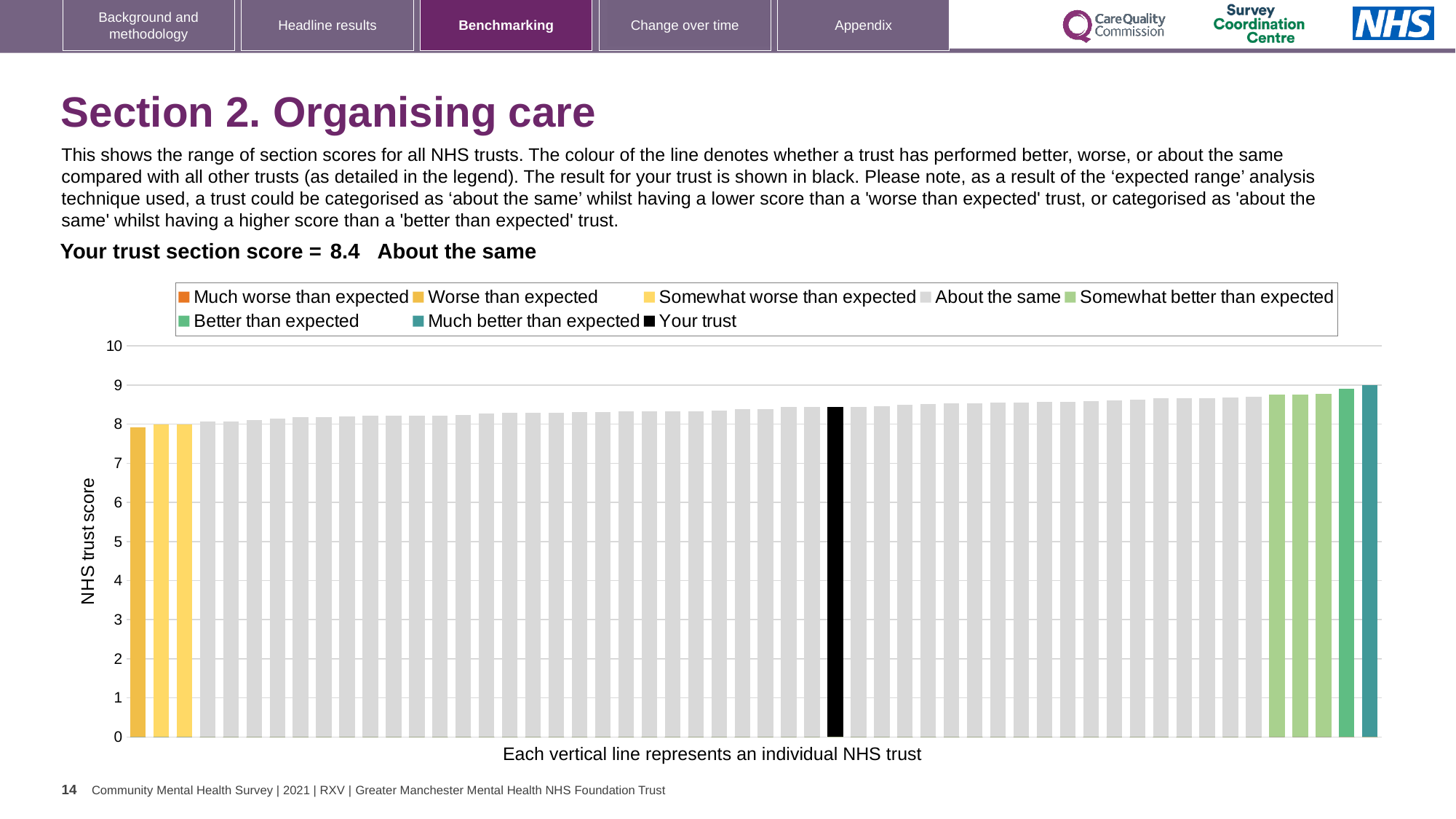
Which legend category does the tallest bar belong to? Much better than expected What is the section score for your trust? 8.4 Is the value of the tallest bar greater or less than 8? greater How many entries does the chart legend list? 8 What is the label on the vertical axis? NHS trust score Is the value for your trust greater or less than 9? less Which legend category does the shortest bar belong to? Worse than expected Is the value for your trust greater or less than 8? greater What colour is the bar representing your trust? black Which category is your trust's section score placed in? About the same What kind of chart is shown on the slide? bar chart Do the bar values rise or fall from left to right along the x axis? rise